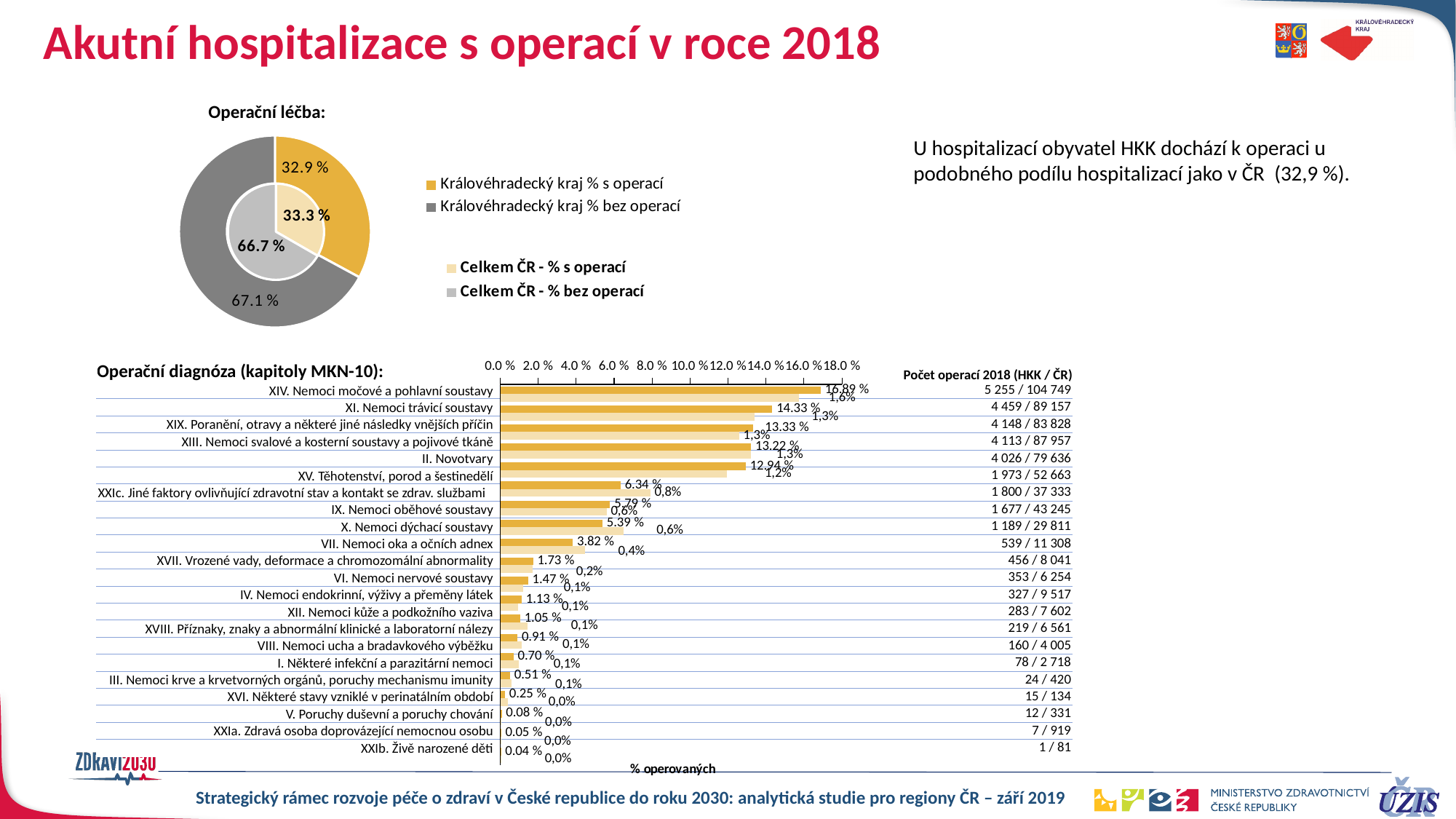
What kind of chart is the 'Operační diagnóza (kapitoly MKN-10)' chart? bar chart On the doughnut chart 'Operační léčba', how many entries does the legend list? 4 On the bar chart 'Operační diagnóza (kapitoly MKN-10)', which category has the lowest value? V. Poruchy duševní a poruchy chování On the bar chart 'Operační diagnóza (kapitoly MKN-10)', how many diagnosis categories are listed? 22 On the bar chart 'Operační diagnóza (kapitoly MKN-10)', is the dark-bar value for XV. Těhotenství, porod a šestinedělí greater or less than 10.0 %? less On the doughnut chart 'Operační léčba', what is the value for Celkem ČR - % bez operací? 66.7 % On the bar chart 'Operační diagnóza (kapitoly MKN-10)', what is the value for XIV. Nemoci močové a pohlavní soustavy (dark bar)? 16.89 % On the doughnut chart 'Operační léčba', what is the value for Královéhradecký kraj % s operací? 32.9 % On the bar chart 'Operační diagnóza (kapitoly MKN-10)', what is the value for IX. Nemoci oběhové soustavy (dark bar)? 5.39 % On the bar chart 'Operační diagnóza (kapitoly MKN-10)', which category has the highest value? XIV. Nemoci močové a pohlavní soustavy On the bar chart 'Operační diagnóza (kapitoly MKN-10)', what is the difference between the dark-bar values for XIV. Nemoci močové a pohlavní soustavy and XI. Nemoci trávicí soustavy? 2.56 % On the doughnut chart 'Operační léčba', which is larger: Královéhradecký kraj % s operací or Celkem ČR - % s operací? Celkem ČR - % s operací